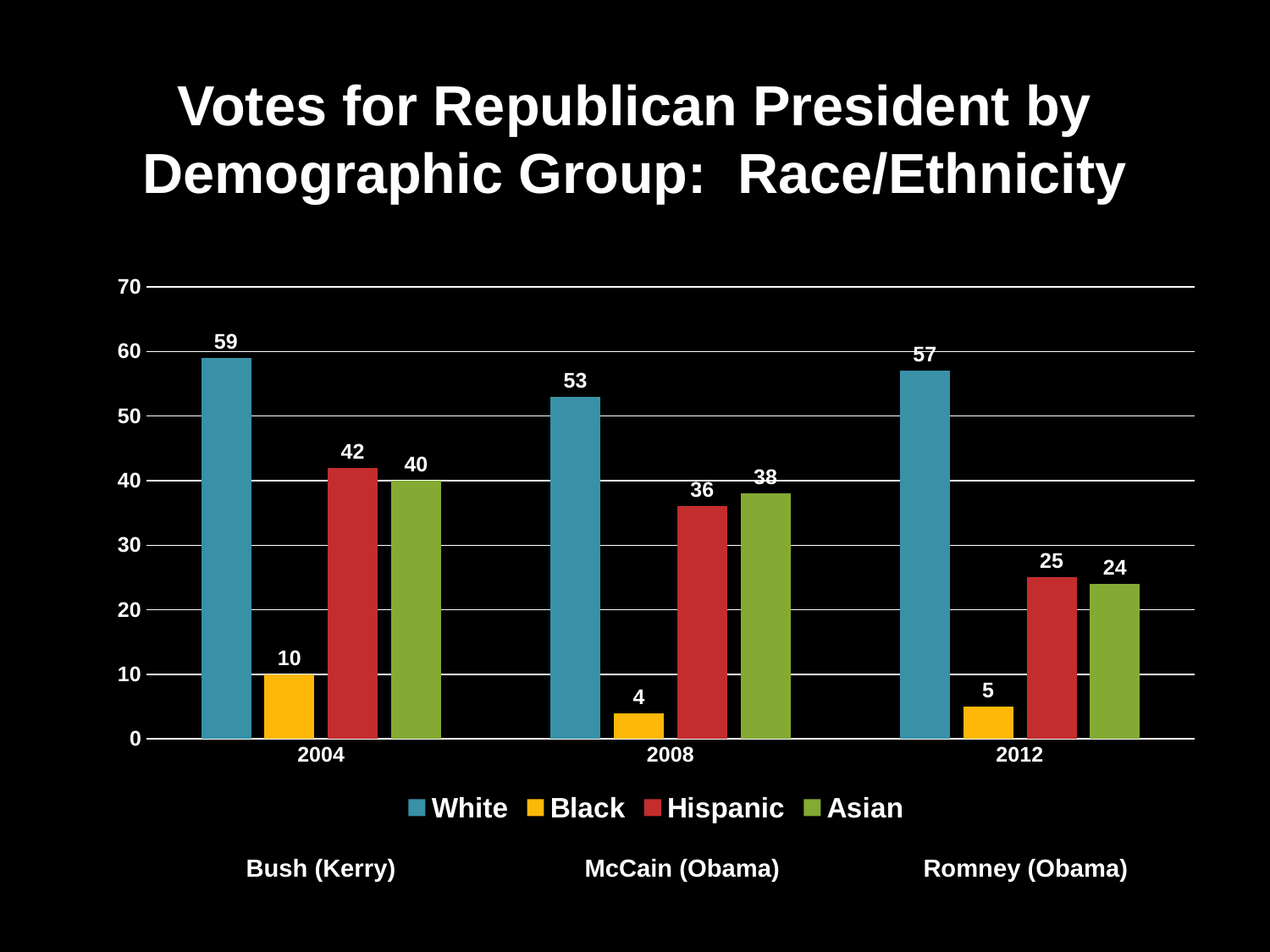
How many series does the legend list? 4 Which year has the lowest value for Black? 2008 Do the Asian values rise or fall from 2004 to 2012? Fall What kind of chart is shown on the slide? Bar chart What is the value for Black in 2008? 4 What is the value for Asian in 2008? 38 What is the value for Hispanic in 2012? 25 Which is larger in 2008, the Hispanic value or the Asian value? Asian What is the value for White in 2004? 59 Which year has the highest value for White? 2004 What is the difference between the Hispanic values in 2004 and 2012? 17 How many years are shown on the x axis? 3